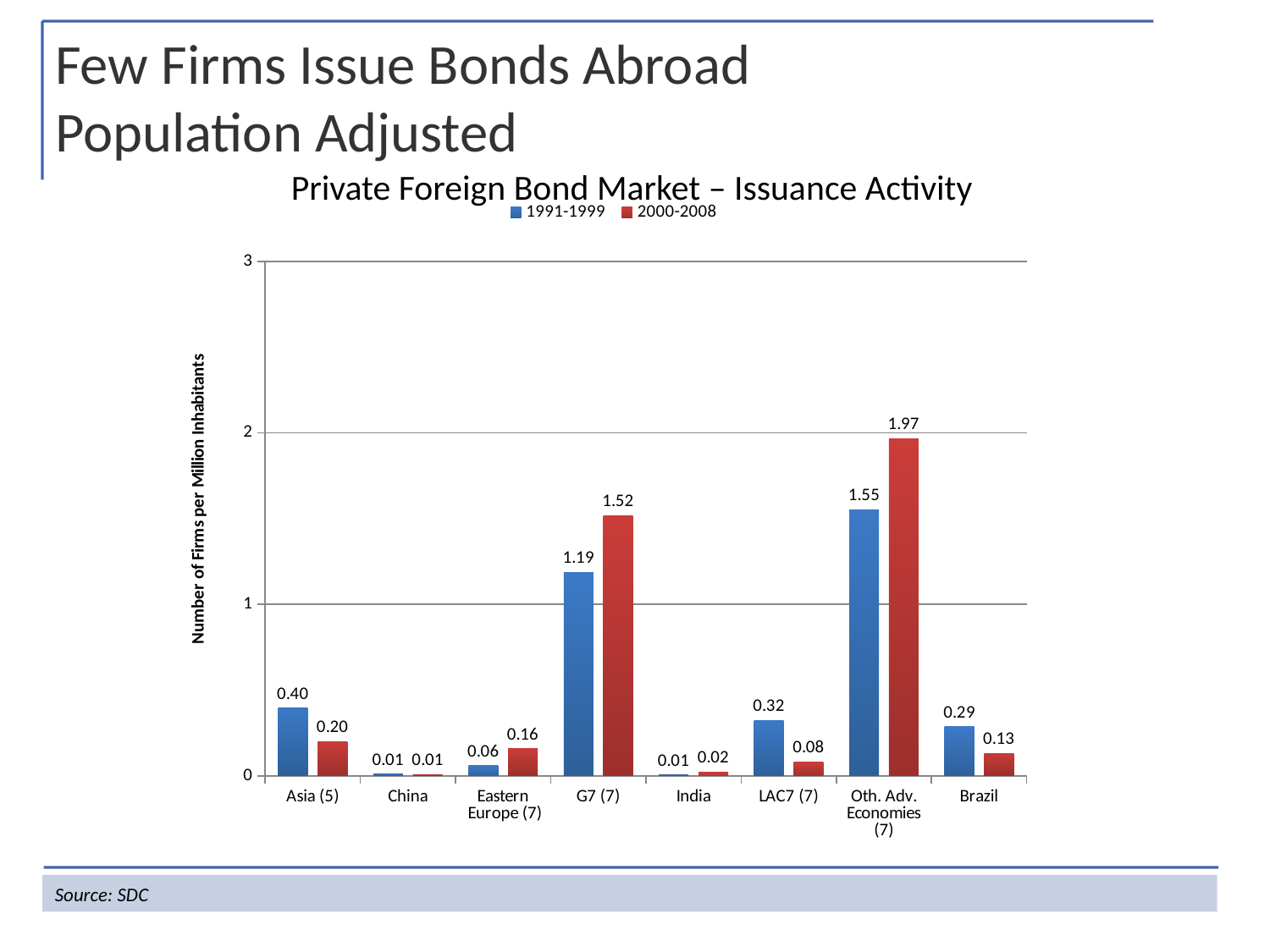
Which category has the lowest value in the 1991-1999 series? China and India (both 0.01) Which category has the highest value in the 2000-2008 series? Oth. Adv. Economies (7) What is the value for G7 (7) in the 2000-2008 series? 1.52 What is the value for Asia (5) in the 1991-1999 series? 0.40 Is the 1991-1999 value for G7 (7) greater or less than 1? greater What is the label of the vertical axis? Number of Firms per Million Inhabitants How many series does the legend list? 2 Which is larger for LAC7 (7): the 1991-1999 value or the 2000-2008 value? 1991-1999 What is the value for Brazil in the 2000-2008 series? 0.13 What kind of chart is shown on the slide? Bar chart What is the difference between the 2000-2008 and 1991-1999 values for Oth. Adv. Economies (7)? 0.42 How many categories are shown on the x axis? 8